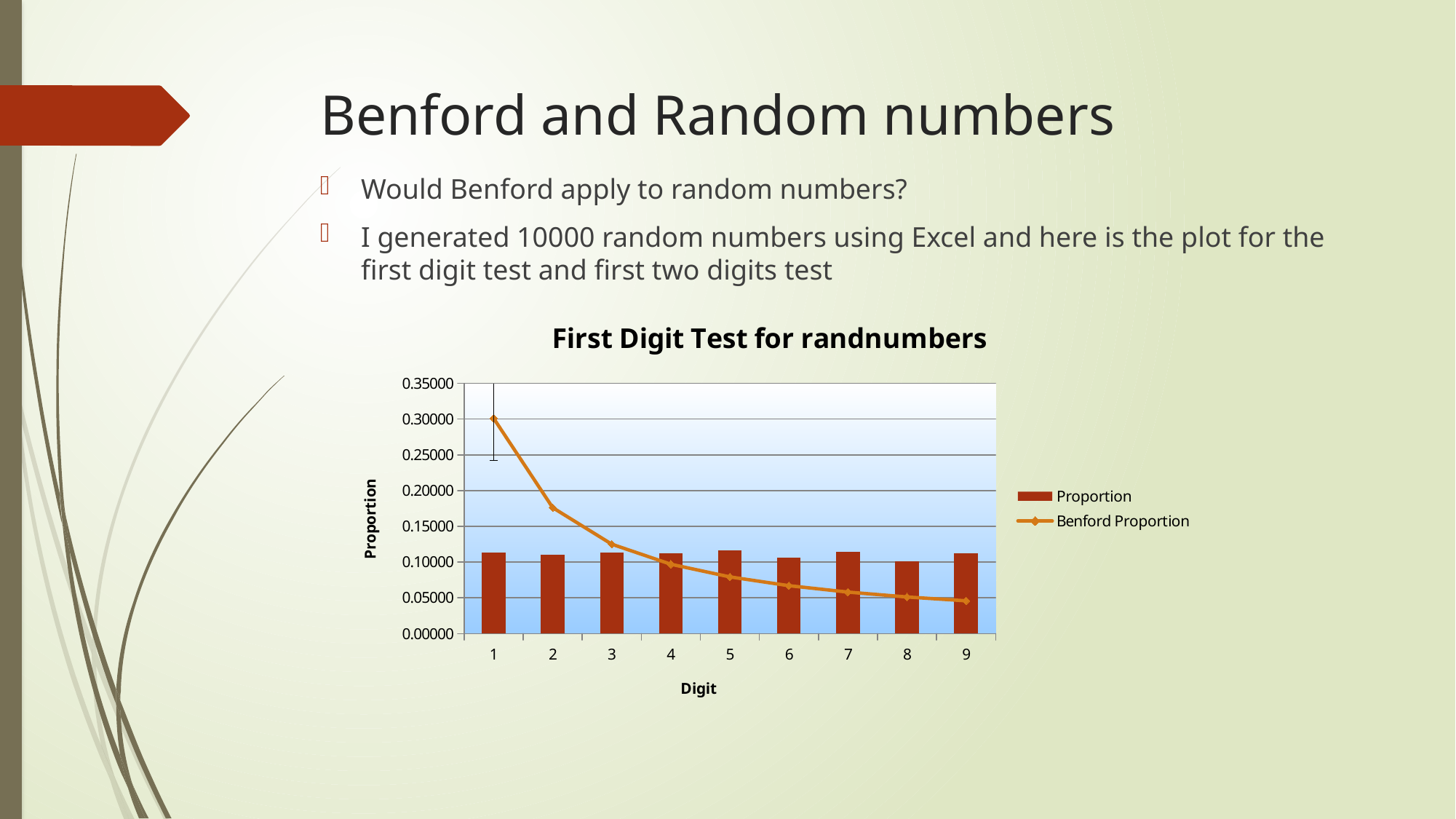
Is the Benford Proportion for digit 2 greater or less than 0.15000? greater For which digit is the Benford Proportion lowest? 9 At digit 1, which is larger: the Proportion bar or the Benford Proportion point? Benford Proportion What is the title of the chart? First Digit Test for randnumbers What kind of chart is this? Combined bar and line chart How many digit categories are shown on the x axis? 9 What are the names of the two series in the legend? Proportion and Benford Proportion Is the Proportion bar for digit 5 greater or less than 0.15000? less For which digit is the Benford Proportion highest? 1 Is the Benford Proportion for digit 1 greater or less than 0.25000? greater Does the Benford Proportion line rise or fall as the digit increases from 1 to 9? Fall How many series does the chart legend list? 2